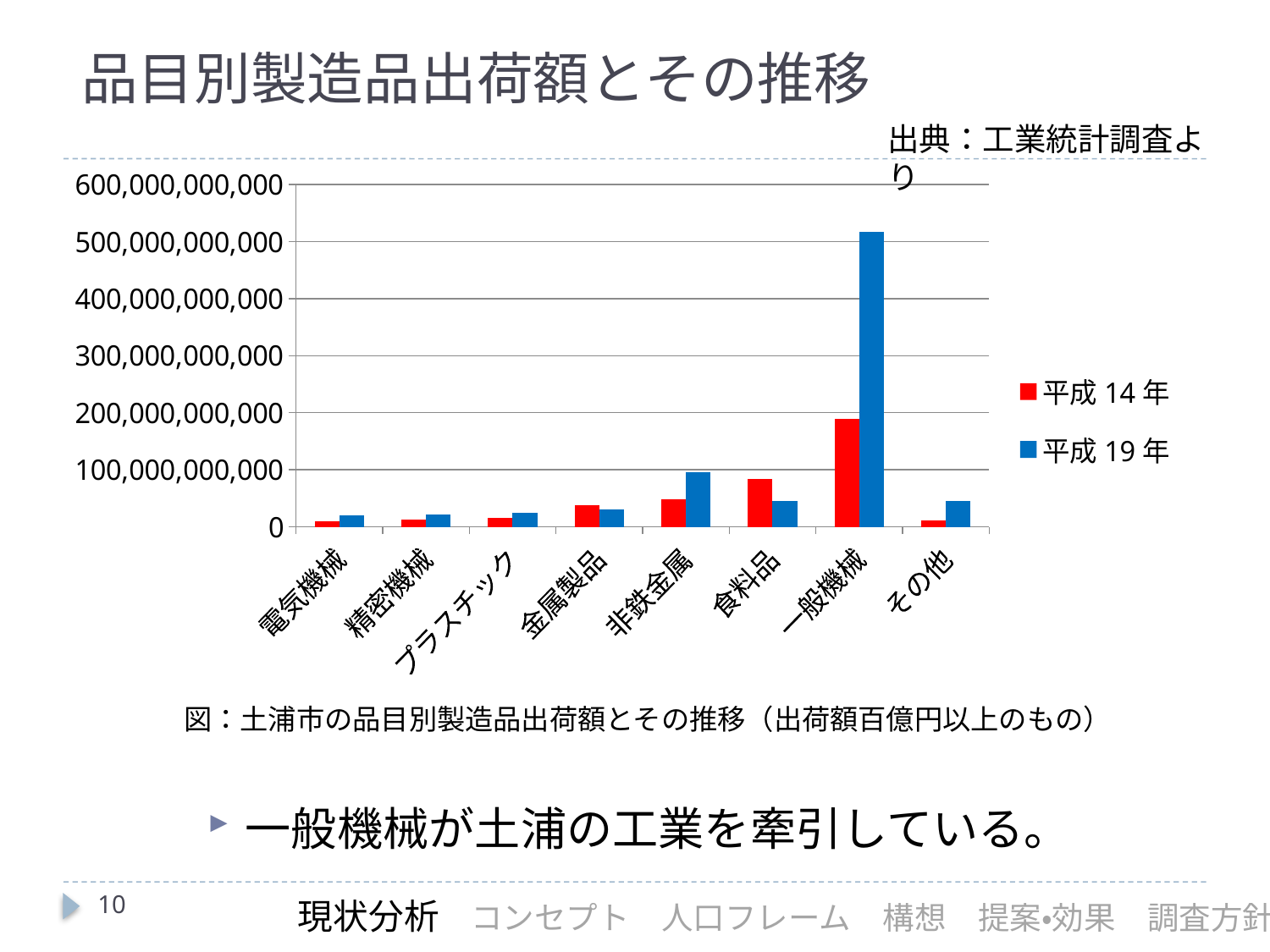
How many categories are shown on the x axis of the chart? 8 How many series does the chart's legend list? 2 Which category has the highest value for 平成14年? 一般機械 Is the 平成14年 value for 一般機械 greater or less than 200,000,000,000? less For 非鉄金属, which series has the larger value, 平成14年 or 平成19年? 平成19年 Is the 平成19年 value for 一般機械 greater or less than 500,000,000,000? greater What is the title of the slide containing the chart? 品目別製造品出荷額とその推移 For 食料品, which series has the larger value, 平成14年 or 平成19年? 平成14年 Which series is shown in blue in the chart's legend? 平成19年 Which category has the highest value for 平成19年? 一般機械 What kind of chart is shown on the slide? bar chart